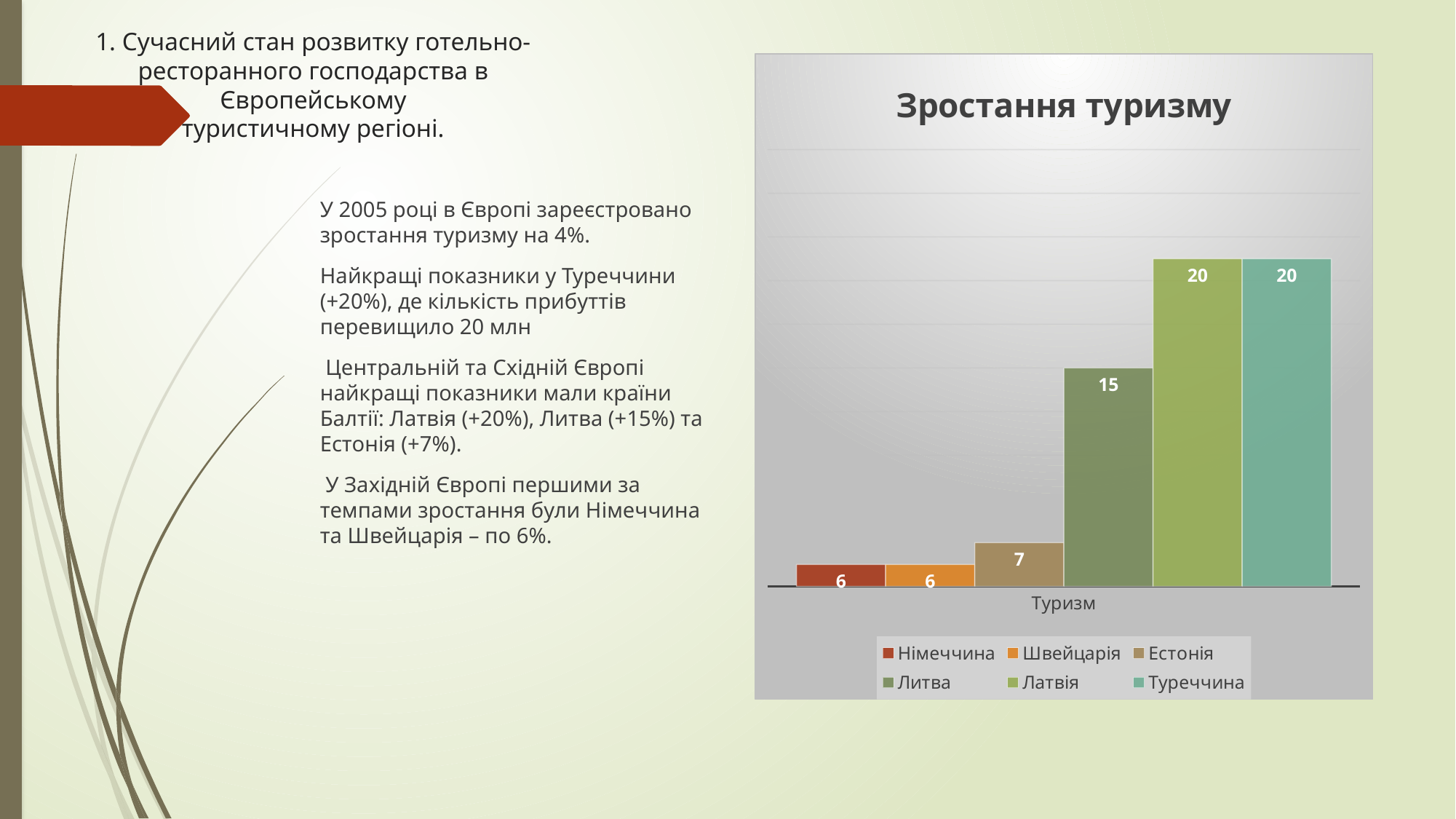
How many series does the legend list? 6 Which has a larger value, Литва or Естонія? Литва What is the difference between the values for Литва and Естонія? 8 What is the value for Швейцарія in the chart? 6 What is the value for Німеччина in the chart? 6 What is the value for Литва in the chart? 15 What is the title of the chart? Зростання туризму What kind of chart is shown on the slide? Bar chart What is the value for Естонія in the chart? 7 What is the difference between the values for Латвія and Литва? 5 What is the value for Туреччина in the chart? 20 Which has a larger value, Латвія or Швейцарія? Латвія